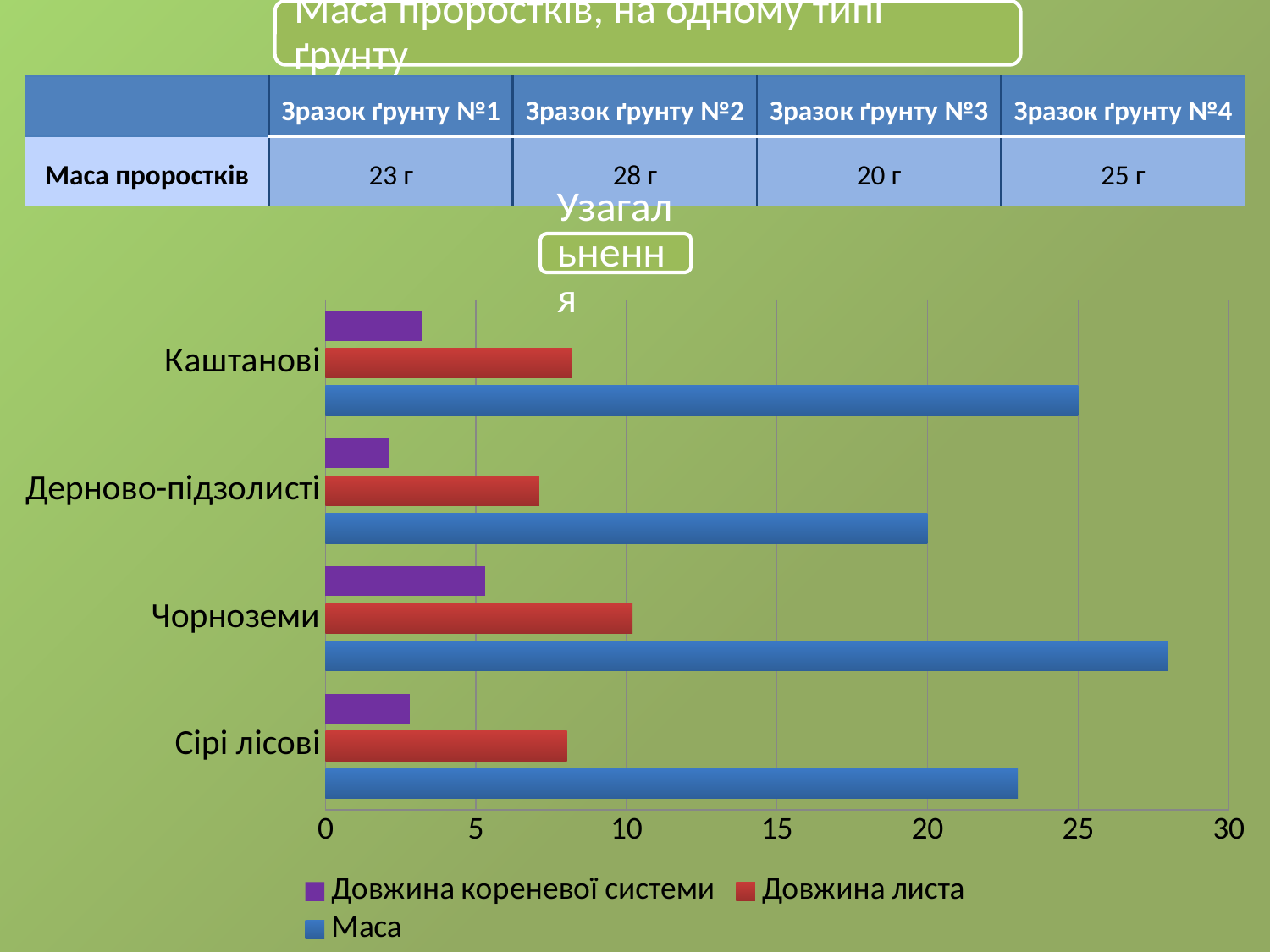
What is the value of Маса for Дерново-підзолисті? 20 Which series is shown in blue in the chart legend? Маса What is the value of Маса for Каштанові? 25 Which category has the lowest Маса value? Дерново-підзолисті Which category has the highest Маса value? Чорноземи How many series does the chart legend list? 3 How many soil-type categories are plotted on the chart? 4 Is the Довжина листа value for Каштанові greater or less than 10? less Which category has the highest value for Довжина кореневої системи? Чорноземи Is the Маса value for Чорноземи greater or less than 25? greater What kind of chart is shown on the slide? bar chart What is the difference between the Маса values for Каштанові and Дерново-підзолисті? 5